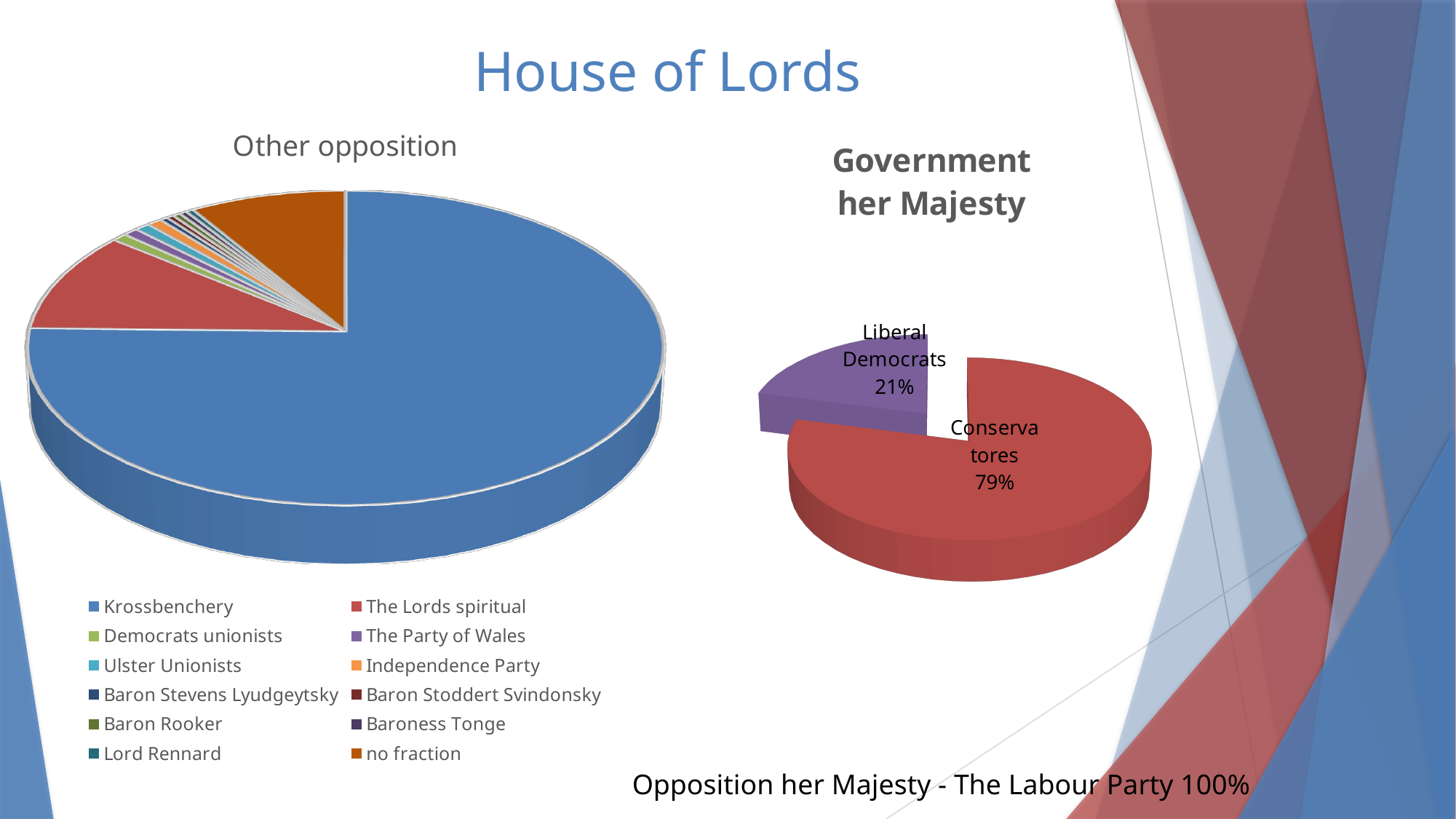
In the 'Government her Majesty' chart, what percentage is shown for Conservatores? 79% What colour is the Krossbenchery slice in the 'Other opposition' chart? Blue In the 'Government her Majesty' chart, what percentage is shown for Liberal Democrats? 21% In the 'Government her Majesty' chart, by how many percentage points does the Conservatores share exceed the Liberal Democrats share? 58 percentage points In the 'Government her Majesty' chart, which party has the smallest share? Liberal Democrats How many categories does the legend of the 'Other opposition' chart list? 12 In the 'Government her Majesty' chart, which party has the largest share? Conservatores How many slices does the 'Government her Majesty' chart have? 2 In the 'Other opposition' chart, which category has the largest slice? Krossbenchery In the 'Other opposition' chart, which slice is larger: Krossbenchery or The Lords spiritual? Krossbenchery What kind of chart is the 'Other opposition' chart? Pie chart What kind of chart is the 'Government her Majesty' chart? Pie chart